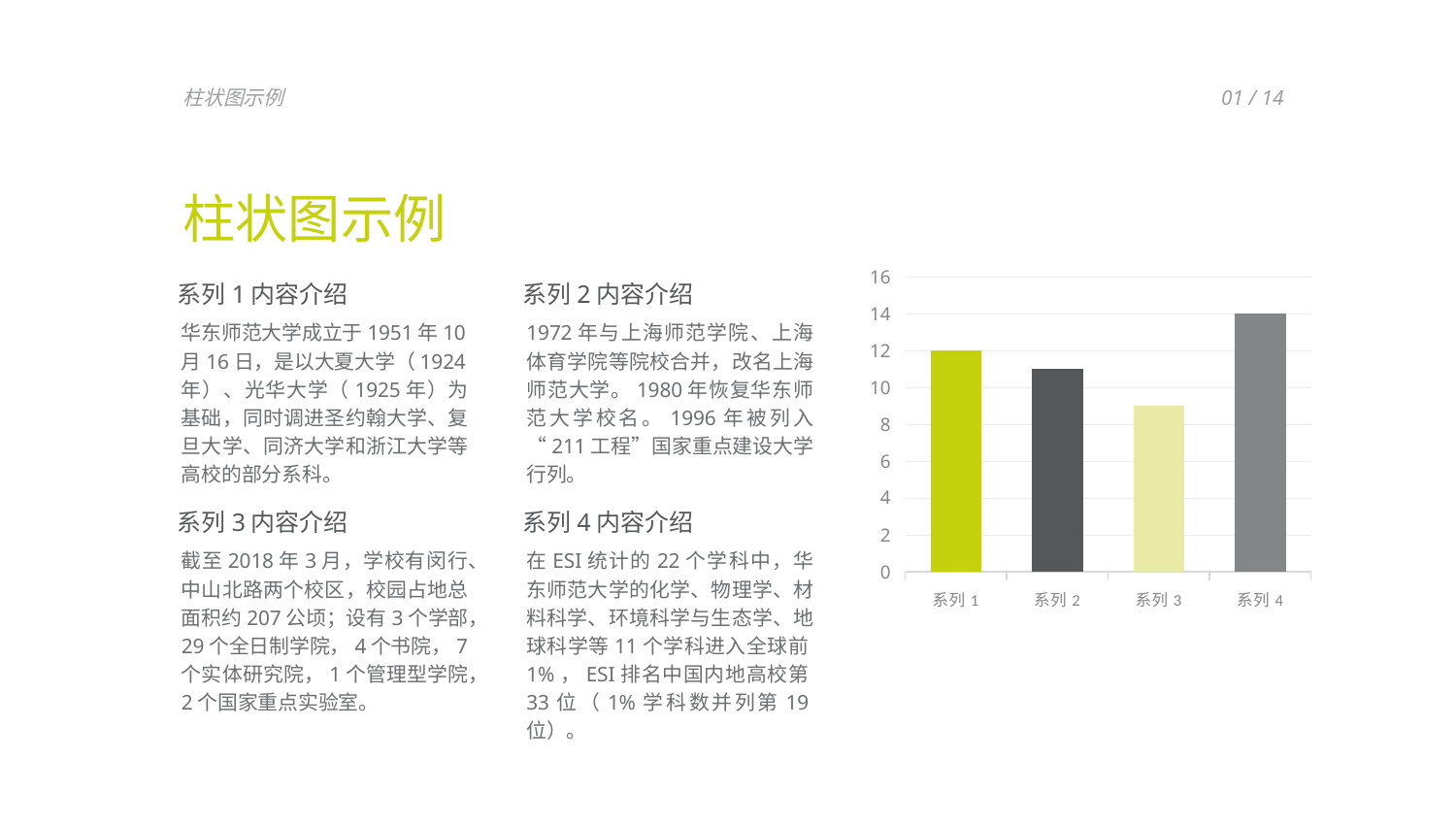
What is the title of the slide containing the chart? 柱状图示例 Which category has the lowest value? 系列 3 Which is larger, the value for 系列 4 or the value for 系列 3? 系列 4 How many categories are plotted on the chart? 4 What is the difference between the values for 系列 4 and 系列 1? 2 What is the value for 系列 4? 14 What is the highest value shown on the vertical axis? 16 Is the value for 系列 3 greater or less than 10? less What is the value for 系列 1? 12 What kind of chart is shown on the slide? bar chart Is the value for 系列 2 greater or less than 10? greater Which category has the highest value? 系列 4